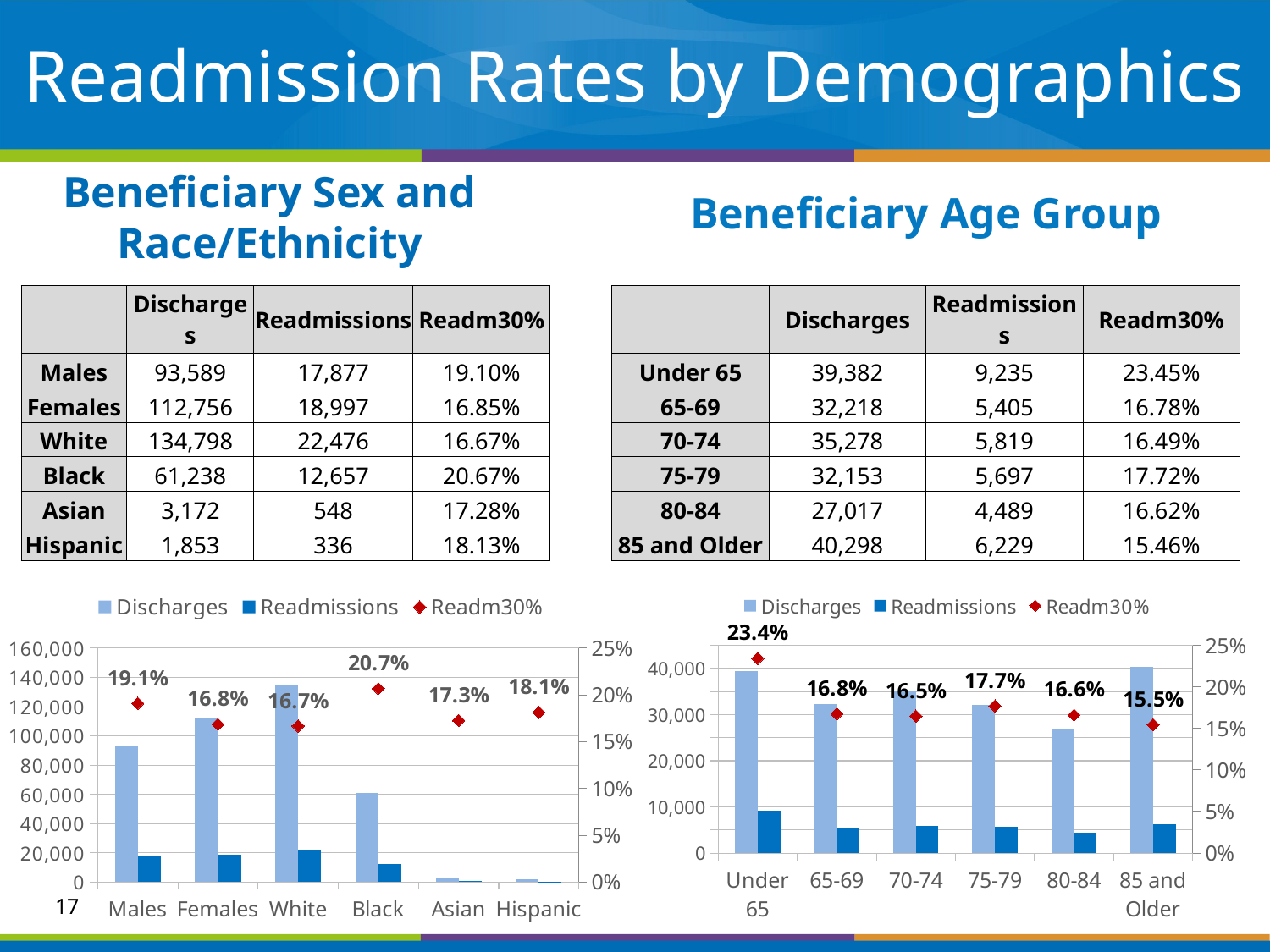
In the Beneficiary Sex and Race/Ethnicity chart, what is the Readm30% value labelled for Black? 20.7% In the Beneficiary Sex and Race/Ethnicity chart, which category has the highest Readm30% label? Black How many series does the legend of the Beneficiary Sex and Race/Ethnicity chart list? 3 In the Beneficiary Sex and Race/Ethnicity chart, what is the Readm30% value labelled for Hispanic? 18.1% In the Beneficiary Age Group chart, is the Discharges bar for 80-84 greater or less than 30,000? less What kind of chart is used for the Beneficiary Age Group data? Bar chart with a line/marker series In the Beneficiary Sex and Race/Ethnicity chart, is the Discharges bar for White greater or less than 120,000? greater In the Beneficiary Age Group chart, what is the Readm30% value labelled for Under 65? 23.4% In the Beneficiary Age Group chart, which age group has the lowest Readm30% label? 85 and Older In the Beneficiary Age Group chart, what is the difference between the Readm30% labels for Under 65 and 85 and Older? 7.9% How many categories are shown on the x axis of the Beneficiary Age Group chart? 6 In the Beneficiary Sex and Race/Ethnicity chart, which has the larger Readm30% label, Males or Females? Males